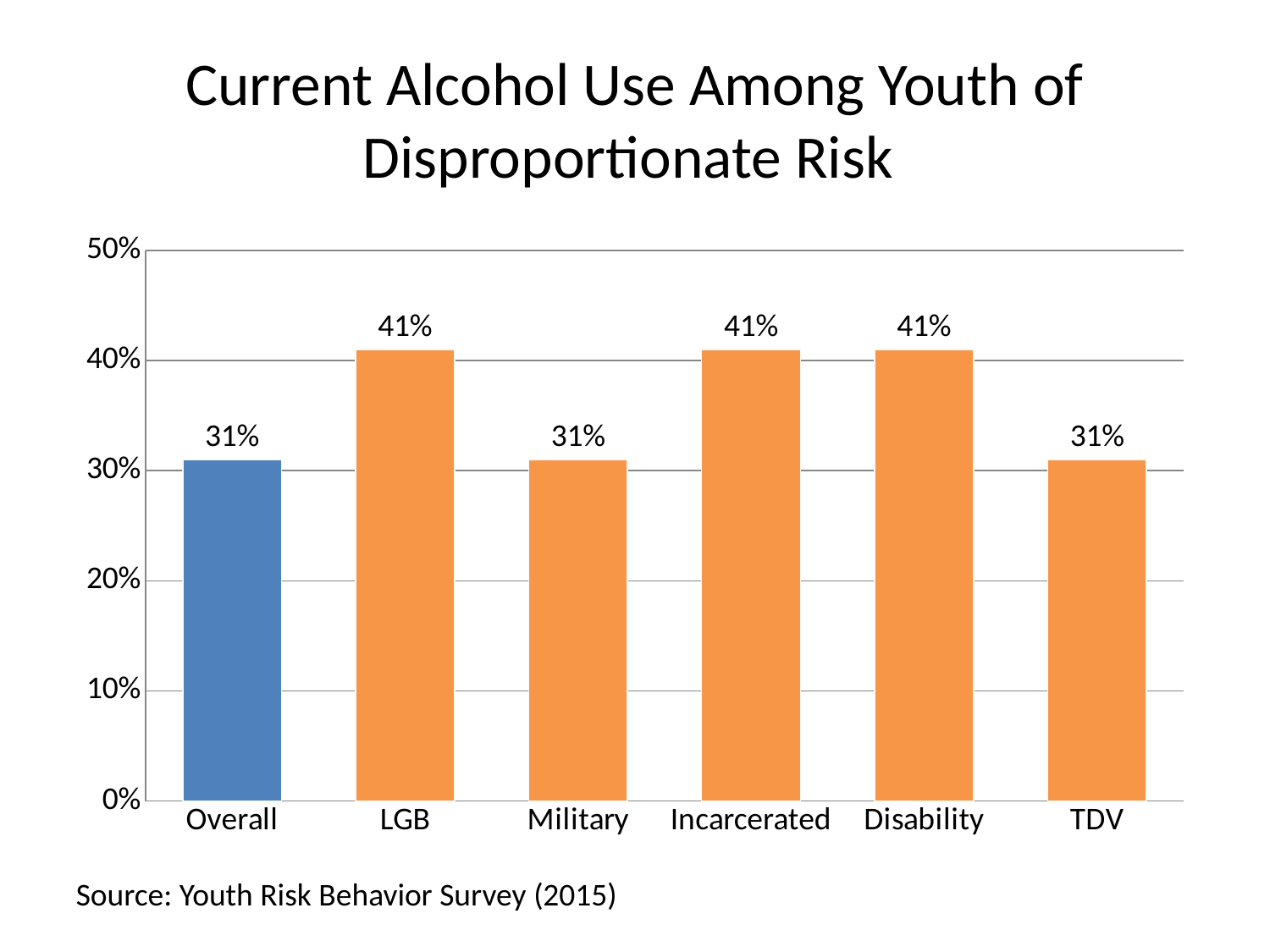
What is the difference between the values for Disability and Overall? 10% What is the value for Incarcerated? 41% Is the value for Incarcerated greater or less than 40%? greater Which is larger, the value for LGB or the value for Military? LGB What is the value for Overall? 31% What is the value for TDV? 31% What kind of chart is this? bar chart What is the value for LGB? 41% How many categories are shown on the x axis? 6 Which bar is a different colour from the others? Overall What is the title of the chart? Current Alcohol Use Among Youth of Disproportionate Risk What is the value for Military? 31%